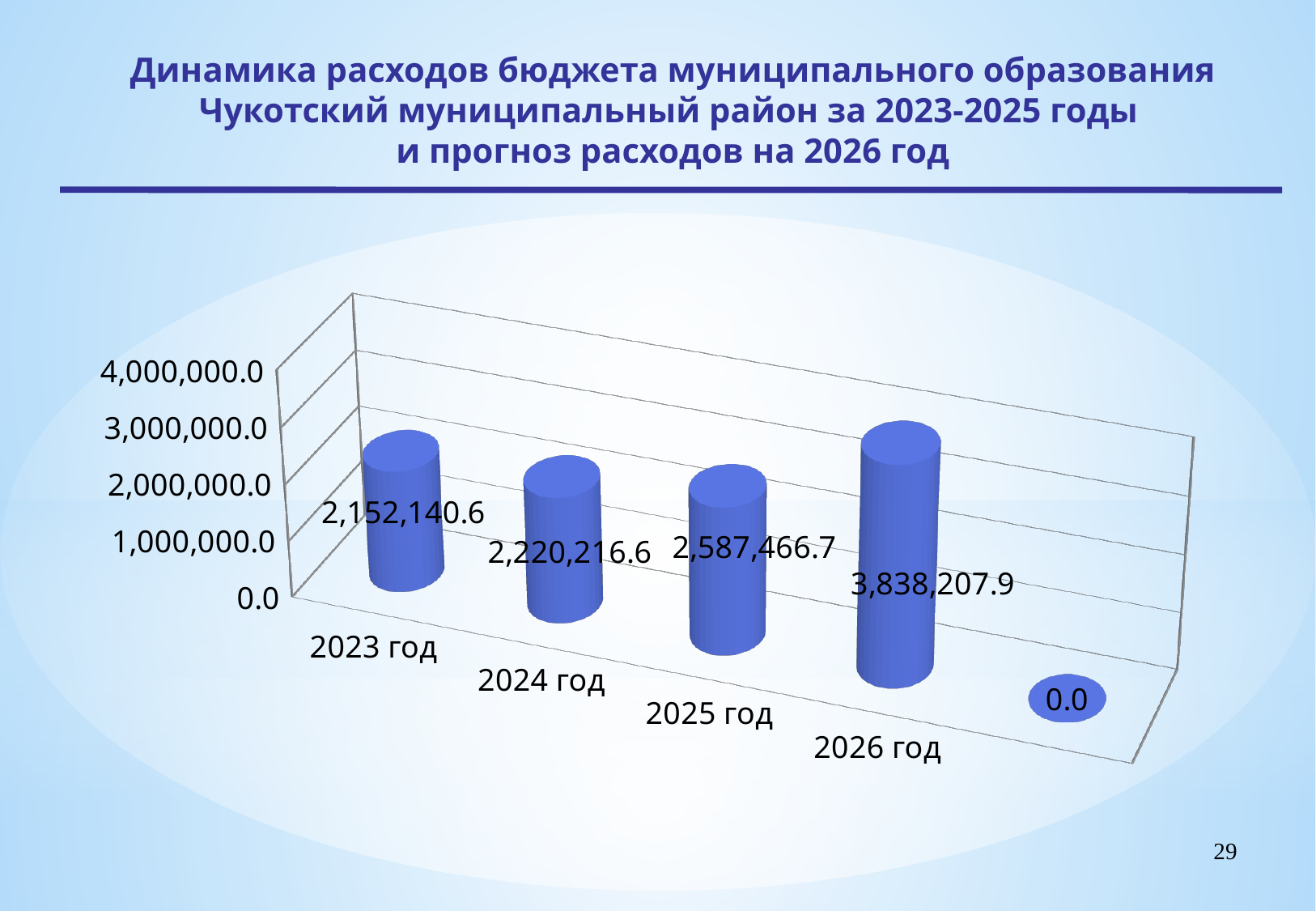
What is the value shown for 2026 год? 3,838,207.9 Is the value for 2026 год greater or less than 3,000,000.0? greater Which of the labeled years has the lowest value? 2023 год What is the difference between the values for 2026 год and 2025 год? 1,250,741.2 Do the values rise or fall from 2023 год to 2026 год? rise What is the value shown for 2023 год? 2,152,140.6 Which year has the highest value? 2026 год Which is larger, the value for 2024 год or the value for 2025 год? 2025 год What kind of chart is shown on the slide? bar chart How many years are labeled on the x axis? 4 What is the difference between the values for 2024 год and 2023 год? 68,076.0 What is the value shown for 2025 год? 2,587,466.7